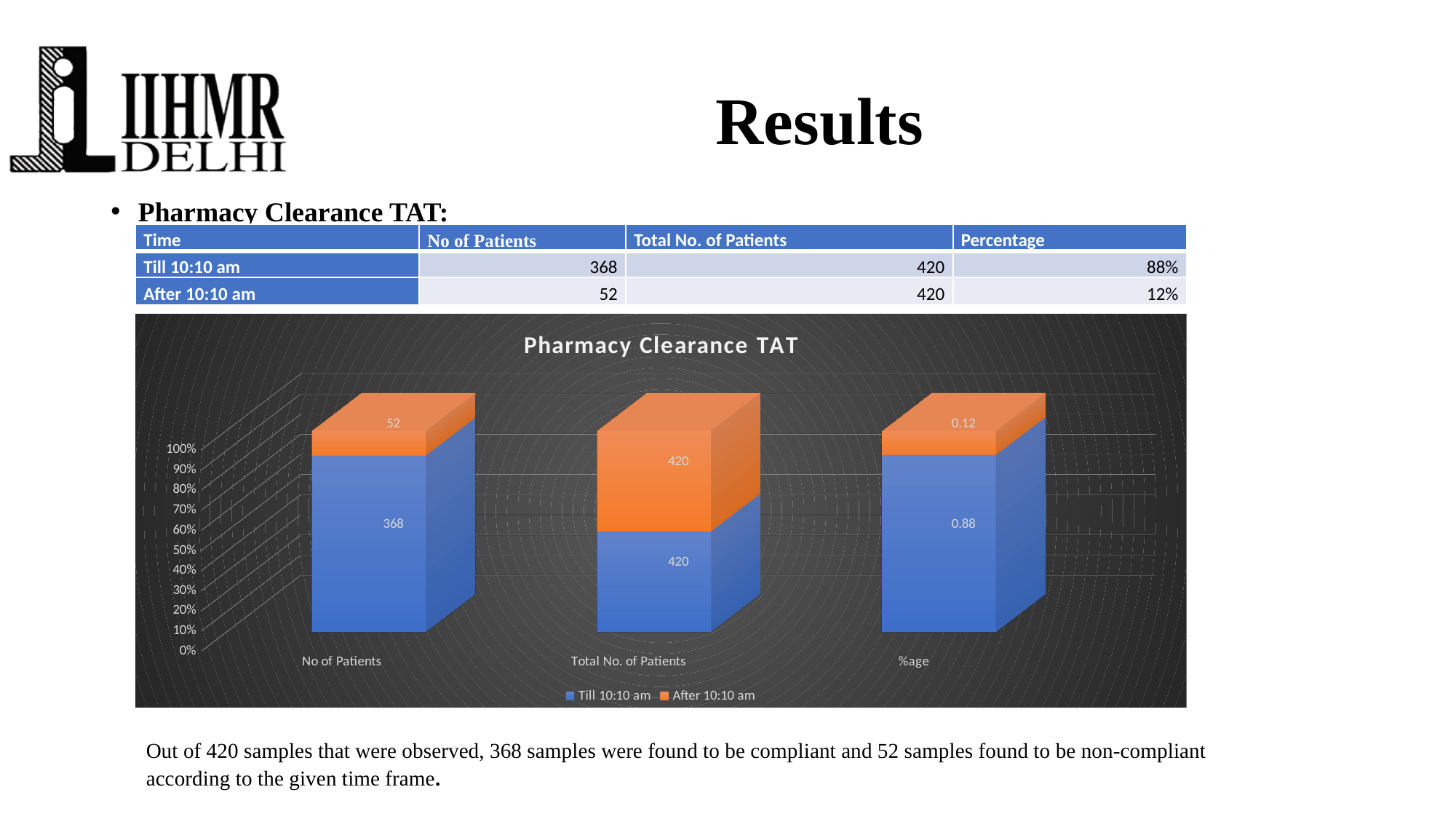
What is the value for After 10:10 am in the %age category? 0.12 In the No of Patients category, which series has the larger value, Till 10:10 am or After 10:10 am? Till 10:10 am Which series is shown in orange in the chart? After 10:10 am How many categories are shown on the x axis of the chart? 3 What is the value for Till 10:10 am in the Total No. of Patients category? 420 What is the value for Till 10:10 am in the No of Patients category? 368 What is the title of the chart? Pharmacy Clearance TAT How many series does the chart legend list? 2 What is the difference between the Till 10:10 am and After 10:10 am values in the No of Patients category? 316 What is the value for Till 10:10 am in the %age category? 0.88 What type of chart is shown on the slide? Stacked bar chart What is the value for After 10:10 am in the No of Patients category? 52